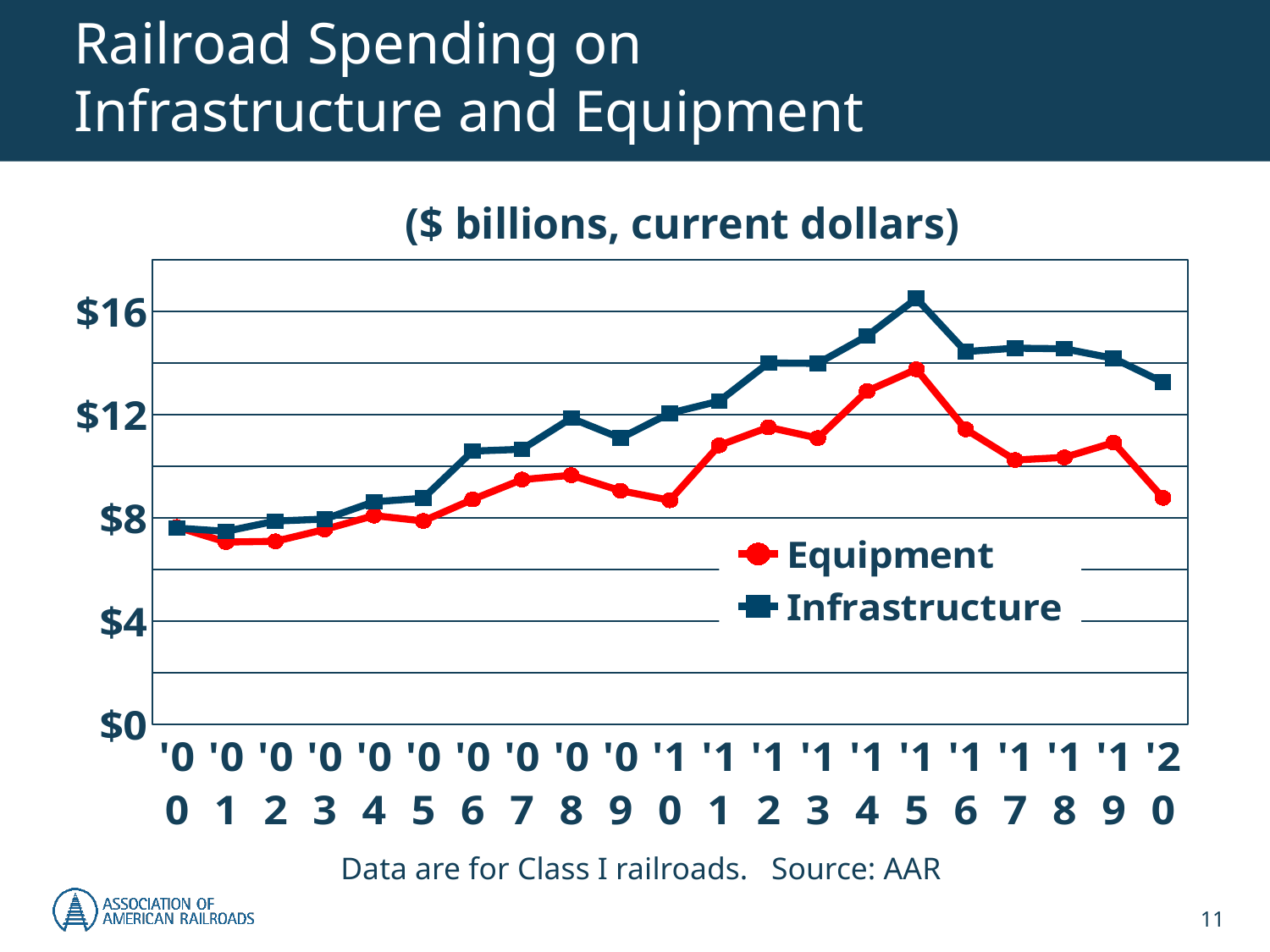
In which year does Infrastructure spending reach its highest value? '15 In which year does Equipment spending reach its highest value? '15 In '10, which series has the larger value, Equipment or Infrastructure? Infrastructure Does Equipment spending rise or fall from '15 to '20? fall Is the Equipment value for '20 greater or less than $8? greater How many series does the legend list? 2 How many years are plotted along the x axis? 21 Is the Infrastructure value for '20 greater or less than $12? greater Which two series are listed in the legend? Equipment and Infrastructure Is the Infrastructure value for '15 greater or less than $16? greater What kind of chart is shown on the slide? line chart